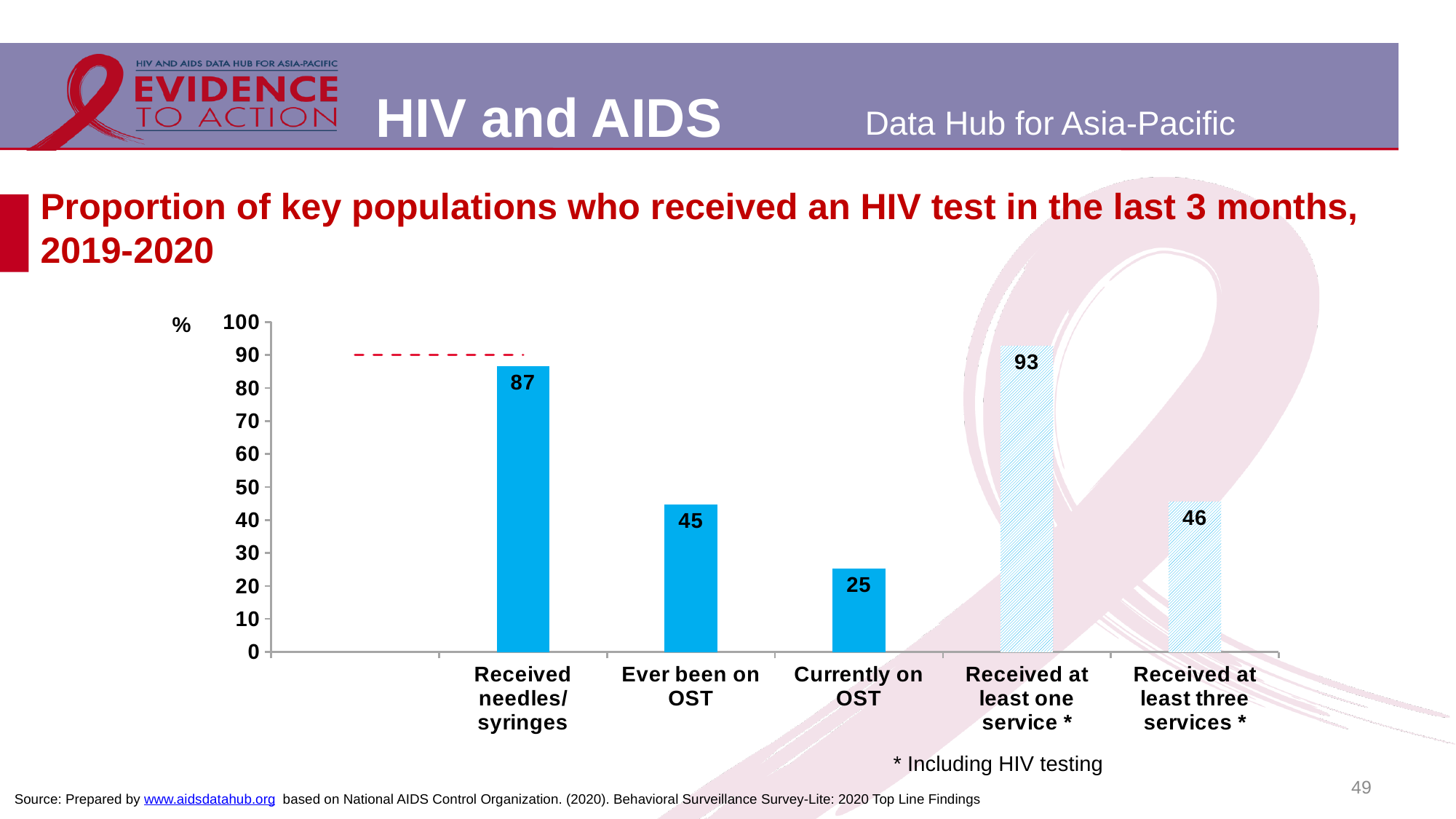
What is the value for 'Received needles/ syringes'? 87 Which category has the highest value? Received at least one service * What is the value for 'Received at least one service *'? 93 What is the difference between the values for 'Received at least one service *' and 'Received at least three services *'? 47 How many categories are shown on the x axis? 5 What is the value for 'Ever been on OST'? 45 Which category has the lowest value? Currently on OST Is the value for 'Received at least three services *' greater or less than 40? greater Which is larger, the value for 'Received needles/ syringes' or the value for 'Ever been on OST'? Received needles/ syringes What kind of chart is shown on the slide? bar chart What is the value for 'Currently on OST'? 25 What does the asterisk (*) in the category labels indicate, according to the note below the chart? Including HIV testing